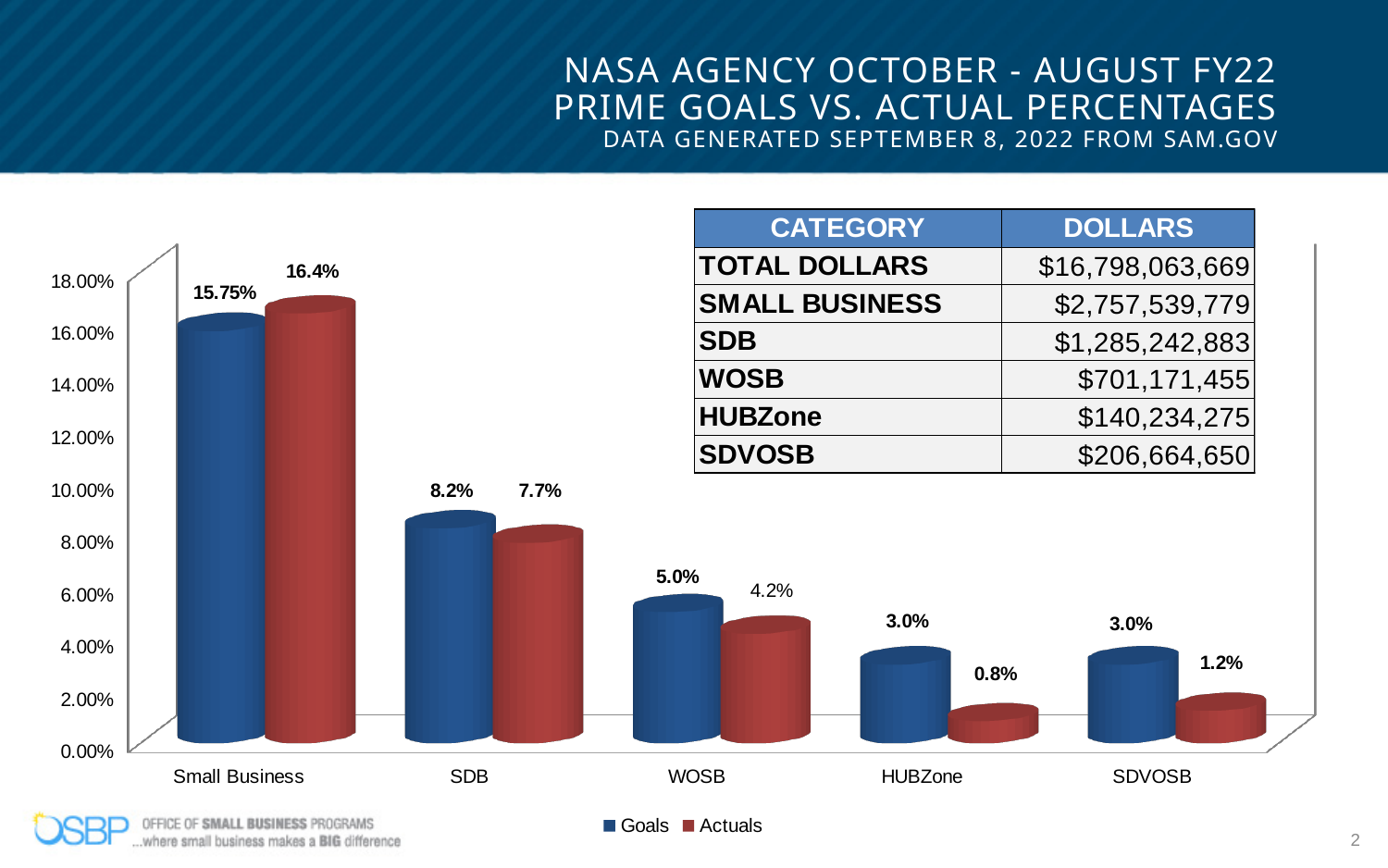
What is the Actuals value for HUBZone? 0.8% How many categories are shown on the x axis of the chart? 5 Which is larger for Small Business, the Goals value or the Actuals value? Actuals How many series does the chart legend list? 2 What is the Actuals value for WOSB? 4.2% What is the difference between the Goals and Actuals values for SDVOSB? 1.8% What is the Goals value for Small Business? 15.75% What is the Goals value for SDB? 8.2% Which category has the lowest Actuals value? HUBZone Which category has the highest Actuals value? Small Business Which series is shown in red in the chart? Actuals What kind of chart is shown on the slide? Bar chart